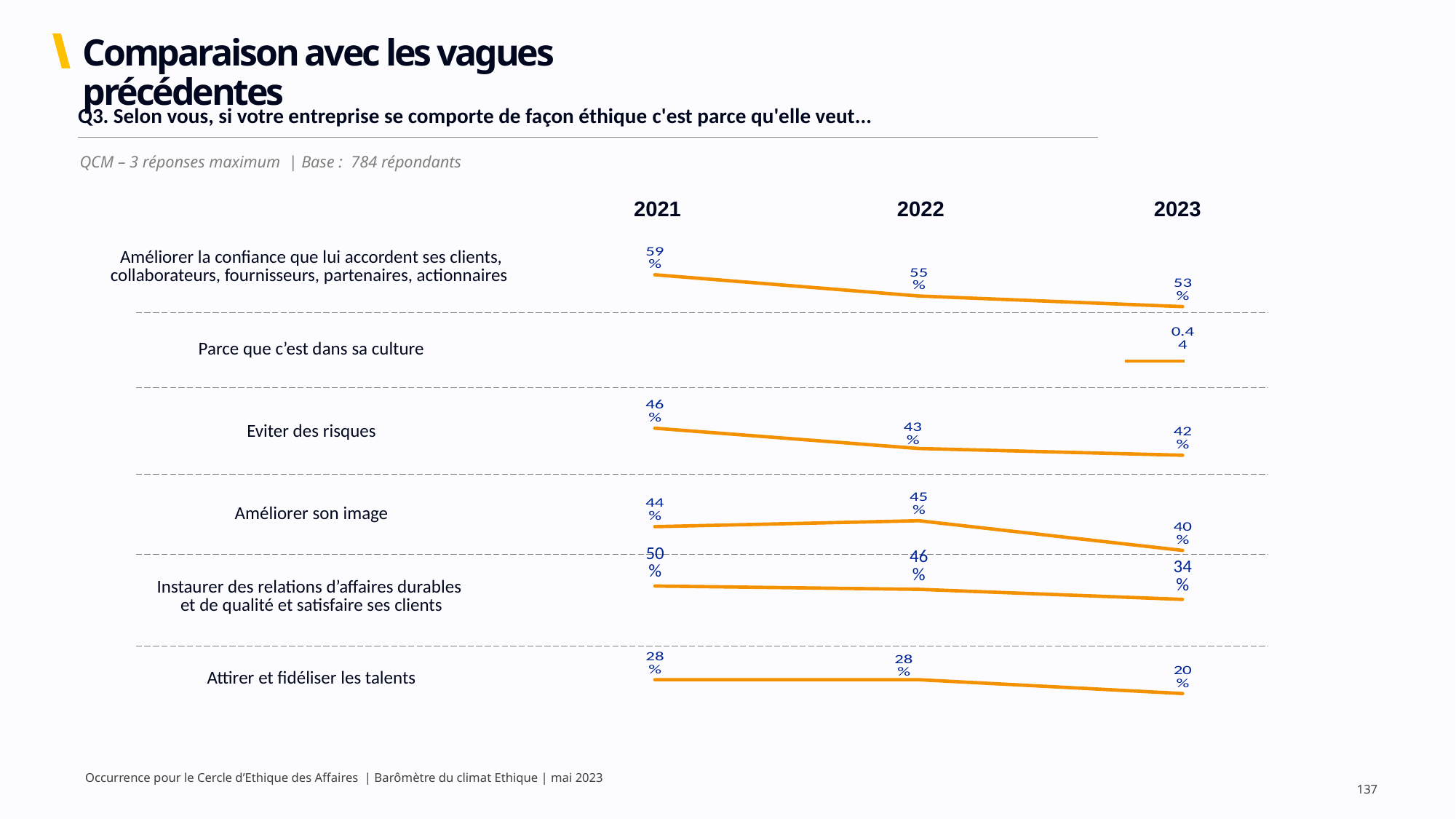
In the 'Améliorer la confiance...' chart, do the values rise or fall from 2021 to 2023? Fall In the 'Améliorer son image' chart, what is the value for 2023? 40% How many years (data points) are plotted in the 'Attirer et fidéliser les talents' chart? 3 In the 'Améliorer son image' chart, which year has the highest value? 2022 In the 'Eviter des risques' chart, what is the value for 2023? 42% In the 'Eviter des risques' chart, which is larger: the 2021 value or the 2022 value? 2021 In the 'Attirer et fidéliser les talents' chart, what is the difference between the 2022 and 2023 values? 8 percentage points In the 'Instaurer des relations d'affaires durables...' chart, what is the value for 2022? 46% In the 'Améliorer la confiance...' chart, what is the difference between the 2021 and 2023 values? 6 percentage points In the 'Améliorer la confiance que lui accordent ses clients, collaborateurs, fournisseurs, partenaires, actionnaires' chart, what is the value for 2021? 59% In the 'Instaurer des relations d'affaires durables et de qualité et satisfaire ses clients' chart, which year has the lowest value? 2023 What kind of chart is used for each row on this slide? Line chart